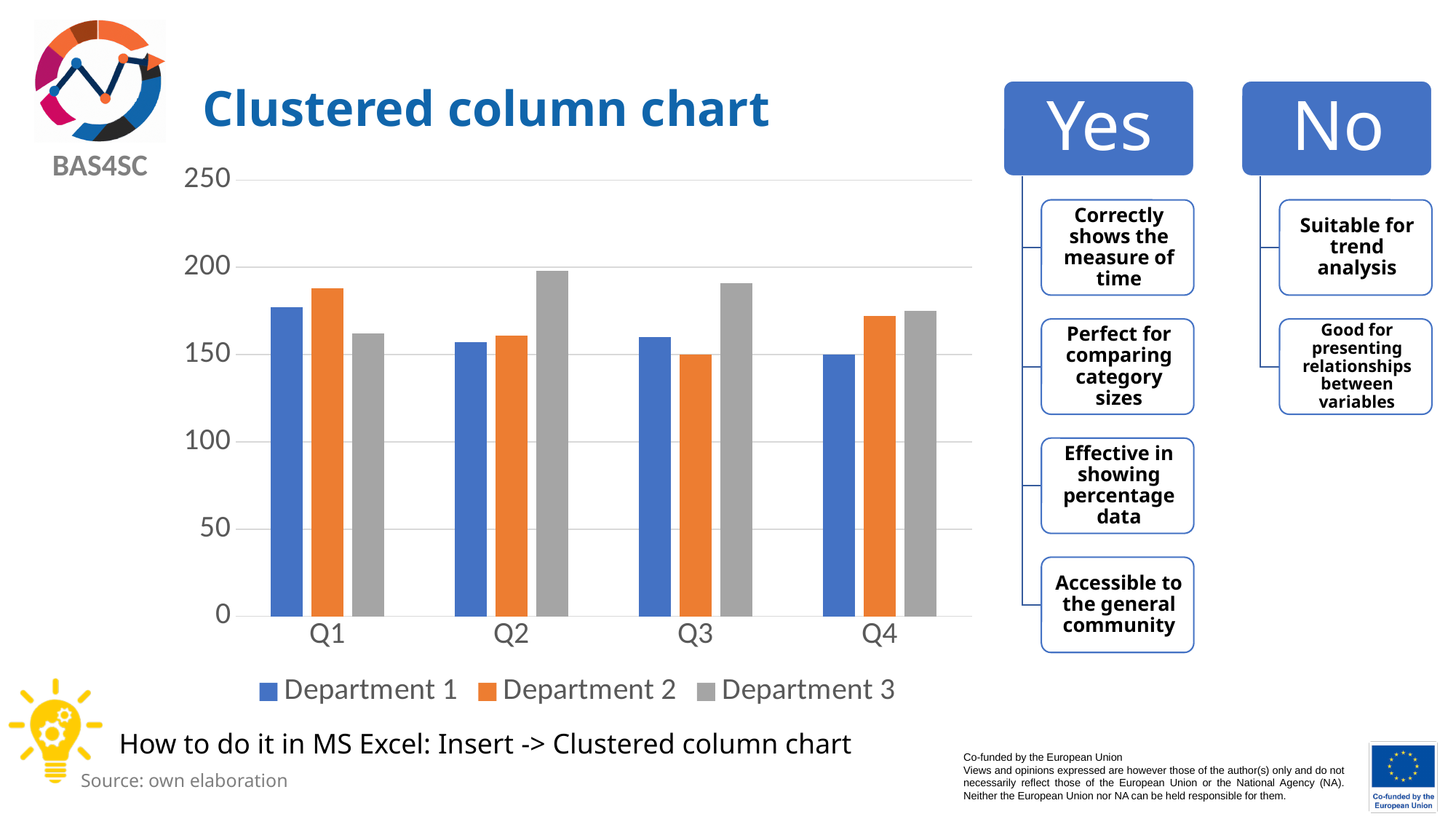
Which is larger in Q3: Department 3 or Department 1? Department 3 What is the title of the chart on the slide? Clustered column chart Is the value for Department 3 in Q2 greater or less than 150? greater How many quarters (categories) are shown on the x axis of the chart? 4 What kind of chart is shown on the slide? bar chart Which colour represents Department 2 in the chart? orange In Q1, which department has the highest bar? Department 2 In Q2, which department has the highest bar? Department 3 Is the value for Department 2 in Q1 greater or less than 200? less Which is larger: Department 1 in Q1 or Department 1 in Q2? Department 1 in Q1 How many series does the chart's legend list? 3 In Q4, which department has the lowest bar? Department 1